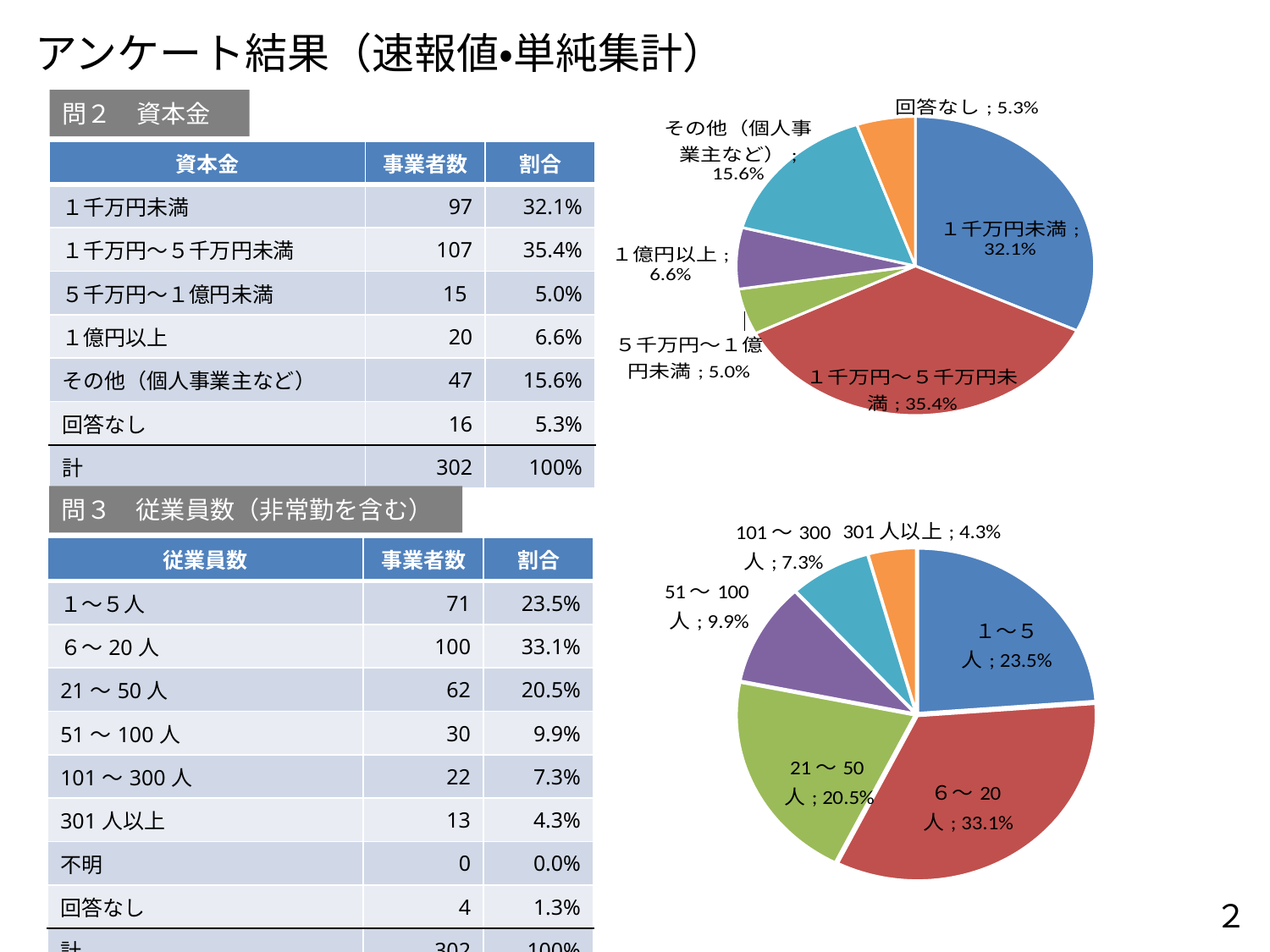
In the top pie chart (問2 資本金), how many slices are there? 6 In the bottom pie chart (問3 従業員数), what share is shown for 6～20人? 33.1% In the top pie chart (問2 資本金), which category has the largest slice? 1千万円～5千万円未満 In the top pie chart (問2 資本金), what is the difference in percentage points between 1千万円未満 and 1億円以上? 25.5 In the top pie chart (問2 資本金), what share is shown for その他（個人事業主など）? 15.6% In the bottom pie chart (問3 従業員数), which category has the largest slice? 6～20人 In the top pie chart (問2 資本金), which category has the smallest slice? 5千万円～1億円未満 In the bottom pie chart (問3 従業員数), what share is shown for 51～100人? 9.9% In the top pie chart (問2 資本金), what share is shown for 1千万円～5千万円未満? 35.4% In the bottom pie chart (問3 従業員数), what colour is the slice for 21～50人? Green What kind of chart is used for 問3 従業員数 on the slide? Pie chart In the bottom pie chart (問3 従業員数), which is larger, the slice for 1～5人 or the slice for 21～50人? 1～5人